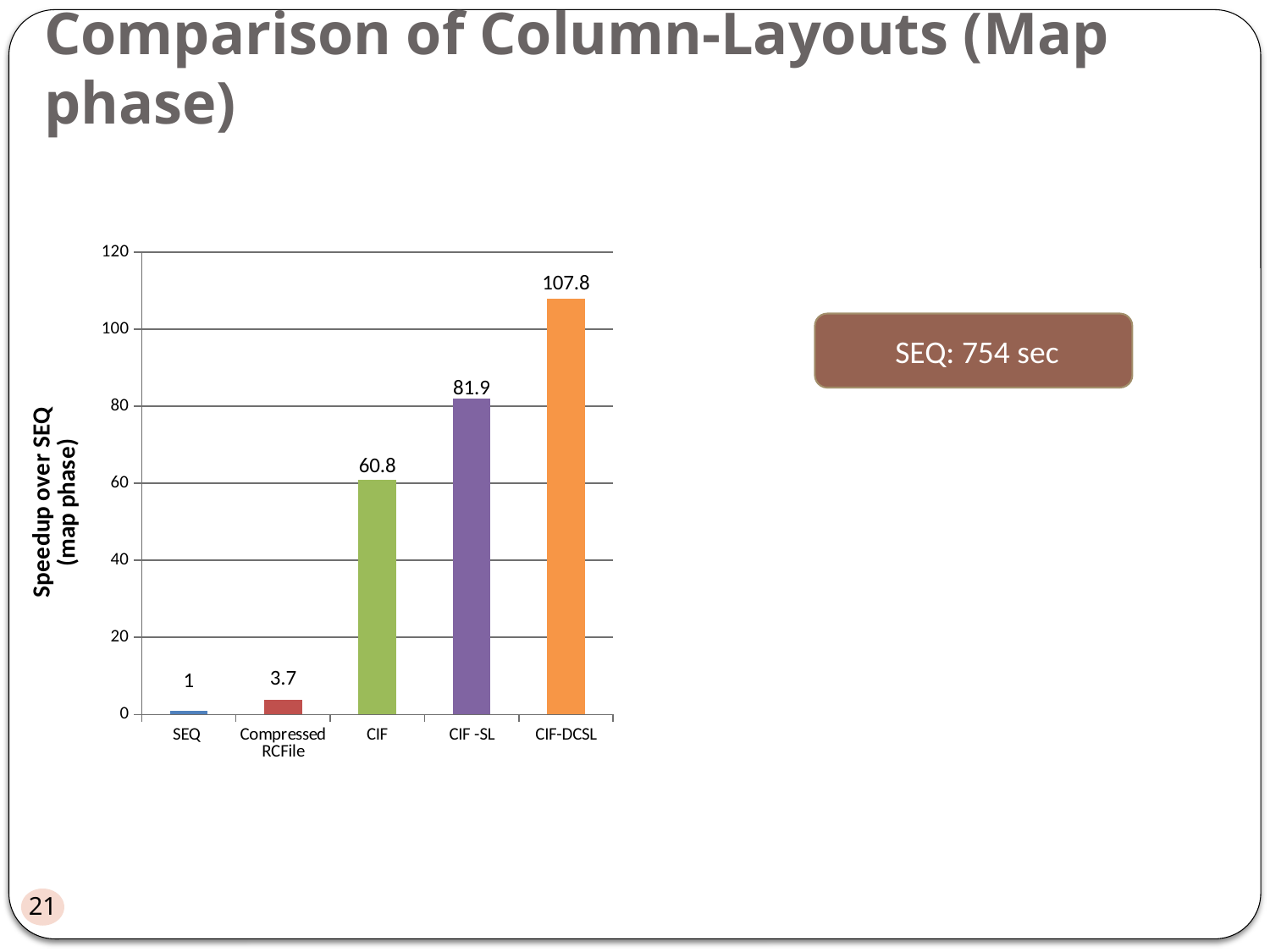
Which column layout has the highest speedup over SEQ? CIF-DCSL What is the speedup over SEQ for CIF -SL? 81.9 What kind of chart is shown on the slide? bar chart What is the label of the y axis? Speedup over SEQ (map phase) Which has a larger speedup, CIF or Compressed RCFile? CIF What is the speedup over SEQ for CIF-DCSL? 107.8 What is the speedup over SEQ for Compressed RCFile? 3.7 How many column layouts are shown on the x axis? 5 Which column layout has the lowest speedup over SEQ? SEQ Is the value for CIF -SL greater or less than 80? greater What is the speedup over SEQ for CIF? 60.8 What is the difference in speedup between CIF-DCSL and CIF -SL? 25.9